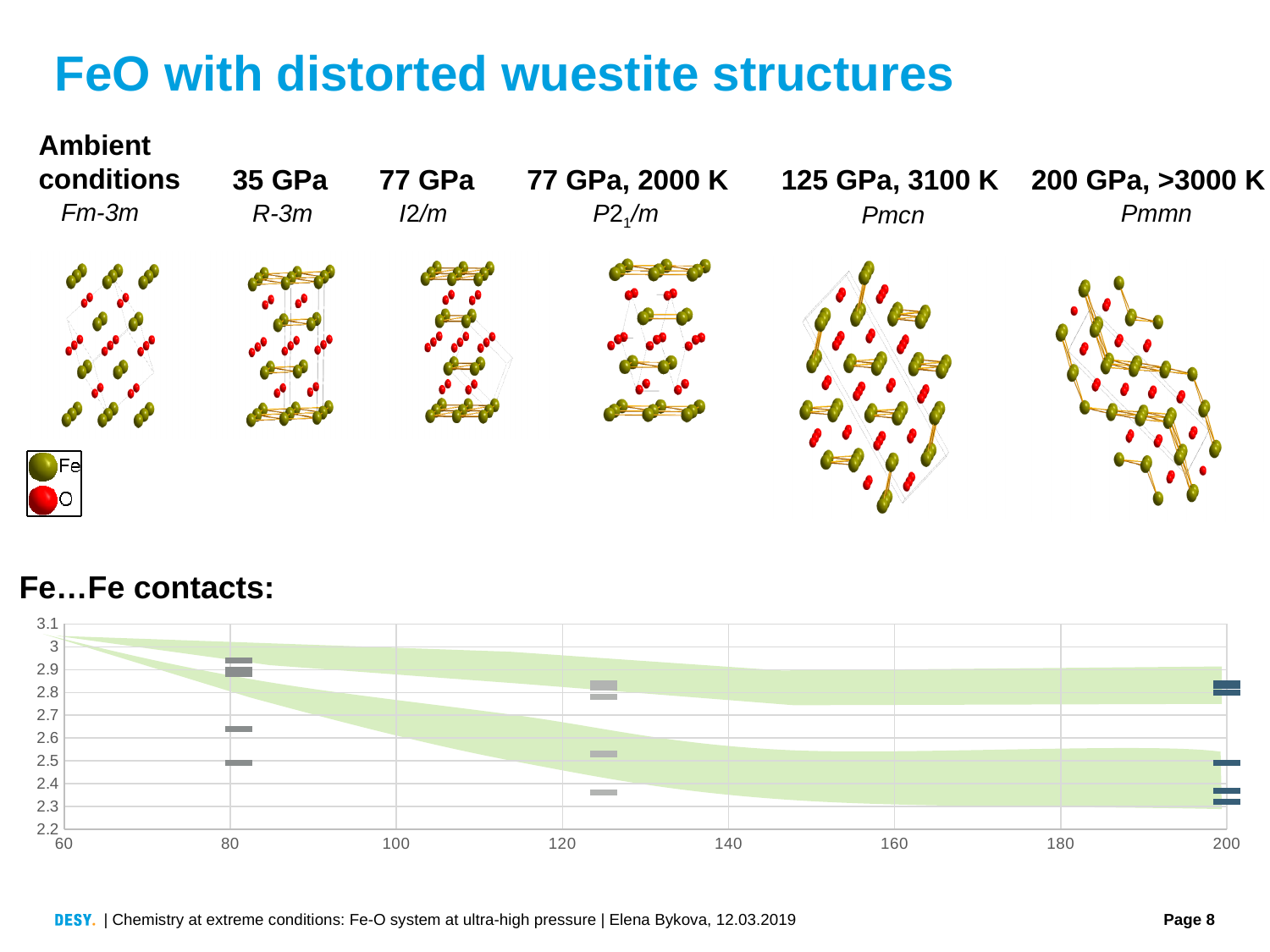
In the Fe…Fe contacts chart, what is the lowest value shown on the y axis? 2.2 In the Fe…Fe contacts chart, do the green shaded bands rise or fall as the x-axis value increases from 60 to 200? fall In the Fe…Fe contacts chart, is the highest marker near x = 200 greater or less than 2.7? greater In the Fe…Fe contacts chart, is the lowest grey marker near x = 80 greater or less than 2.6? less In the Fe…Fe contacts chart, what is the largest value shown on the x axis? 200 In the Fe…Fe contacts chart, which is larger: the highest marker near x = 80 or the highest marker near x = 200? the highest marker near x = 80 In the Fe…Fe contacts chart, how many tick labels are shown along the x axis? 8 In the Fe…Fe contacts chart, is the lowest marker near x = 200 greater or less than 2.4? less In the Fe…Fe contacts chart, what is the highest value shown on the y axis? 3.1 What is the heading printed above the chart at the bottom of the slide? Fe…Fe contacts: